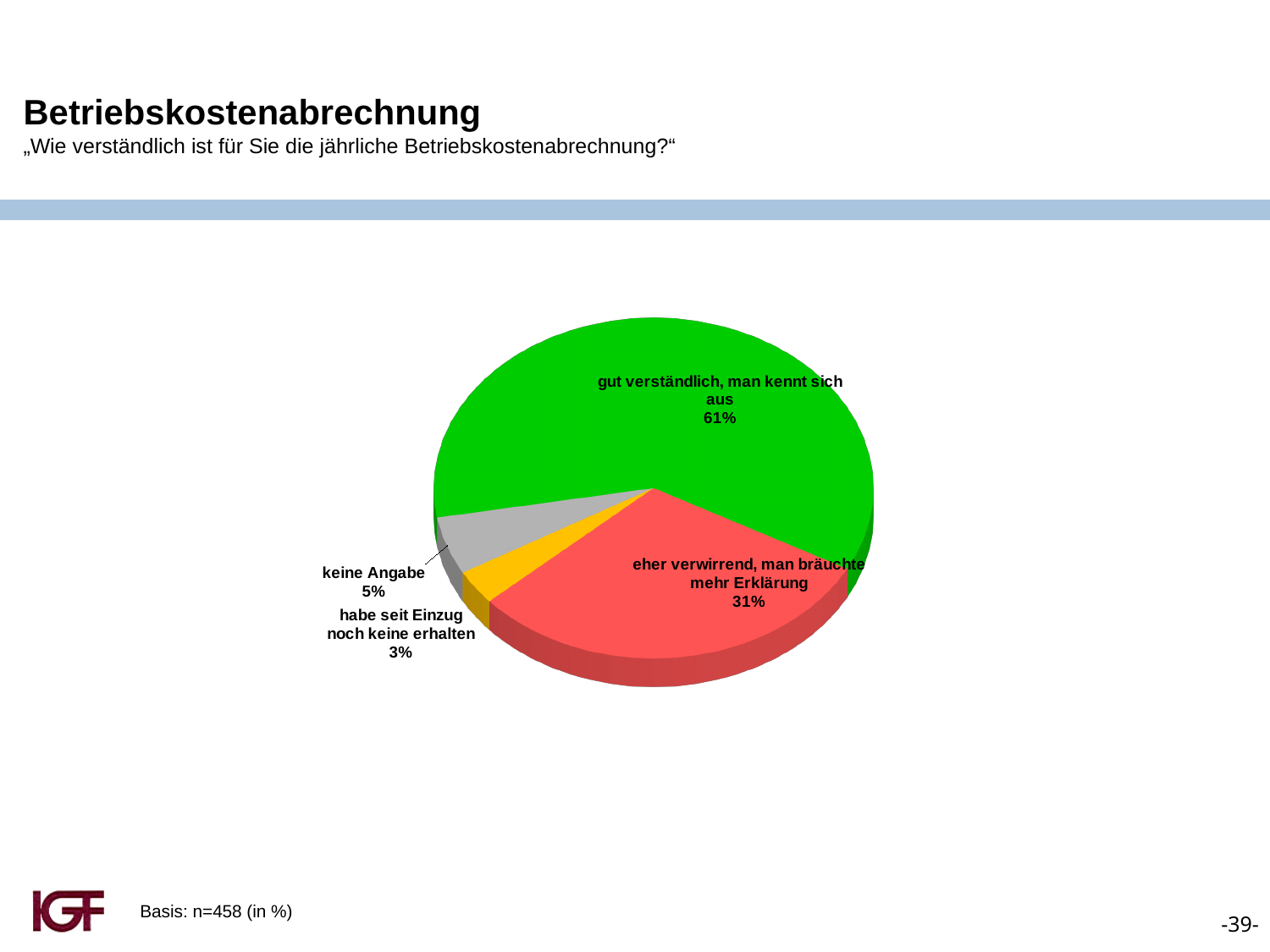
Which is larger: the share for "keine Angabe" or the share for "habe seit Einzug noch keine erhalten"? keine Angabe What percentage of respondents answered "gut verständlich, man kennt sich aus"? 61% What is the sample size (Basis) stated on the slide? n=458 What percentage of respondents answered "habe seit Einzug noch keine erhalten"? 3% What percentage of respondents answered "eher verwirrend, man bräuchte mehr Erklärung"? 31% What share of the pie is "keine Angabe"? 5% What is the difference in percentage points between "gut verständlich, man kennt sich aus" and "eher verwirrend, man bräuchte mehr Erklärung"? 30 How many slices does the pie chart have? 4 Which response category has the smallest share of the pie? habe seit Einzug noch keine erhalten Which response category has the largest share of the pie? gut verständlich, man kennt sich aus What colour is the slice for "eher verwirrend, man bräuchte mehr Erklärung"? red What type of chart is shown on the slide? pie chart